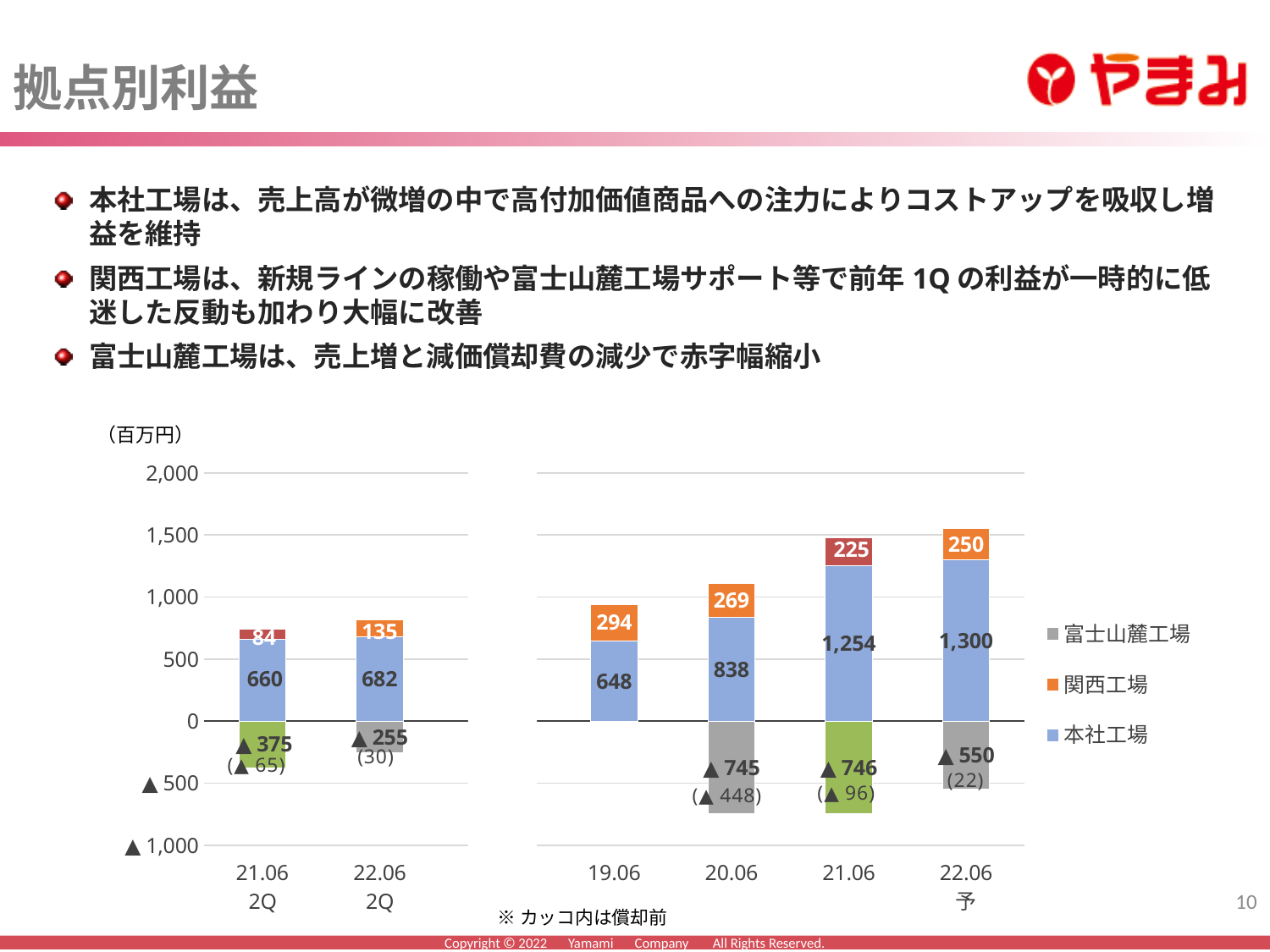
In the right chart, which period has the lowest value for 関西工場? 21.06 In the right chart, which is larger, the 関西工場 value for 20.06 or for 22.06 予? 20.06 What kind of chart is used on this slide? Stacked bar chart How many series does the legend list? 3 How many periods are shown on the x axis of the right chart? 4 In the right chart, what is the value for 関西工場 in 19.06? 294 In the right chart, does the 本社工場 value rise or fall from 19.06 to 22.06 予? Rise In the right chart, what is the value for 本社工場 in 21.06? 1,254 In the left chart, what is the value for 関西工場 in 22.06 2Q? 135 In the left chart, what is the difference between the 本社工場 values for 22.06 2Q and 21.06 2Q? 22 In the right chart, which period has the highest value for 本社工場? 22.06 予 In the right chart, what is the value for 富士山麓工場 in 20.06? ▲745